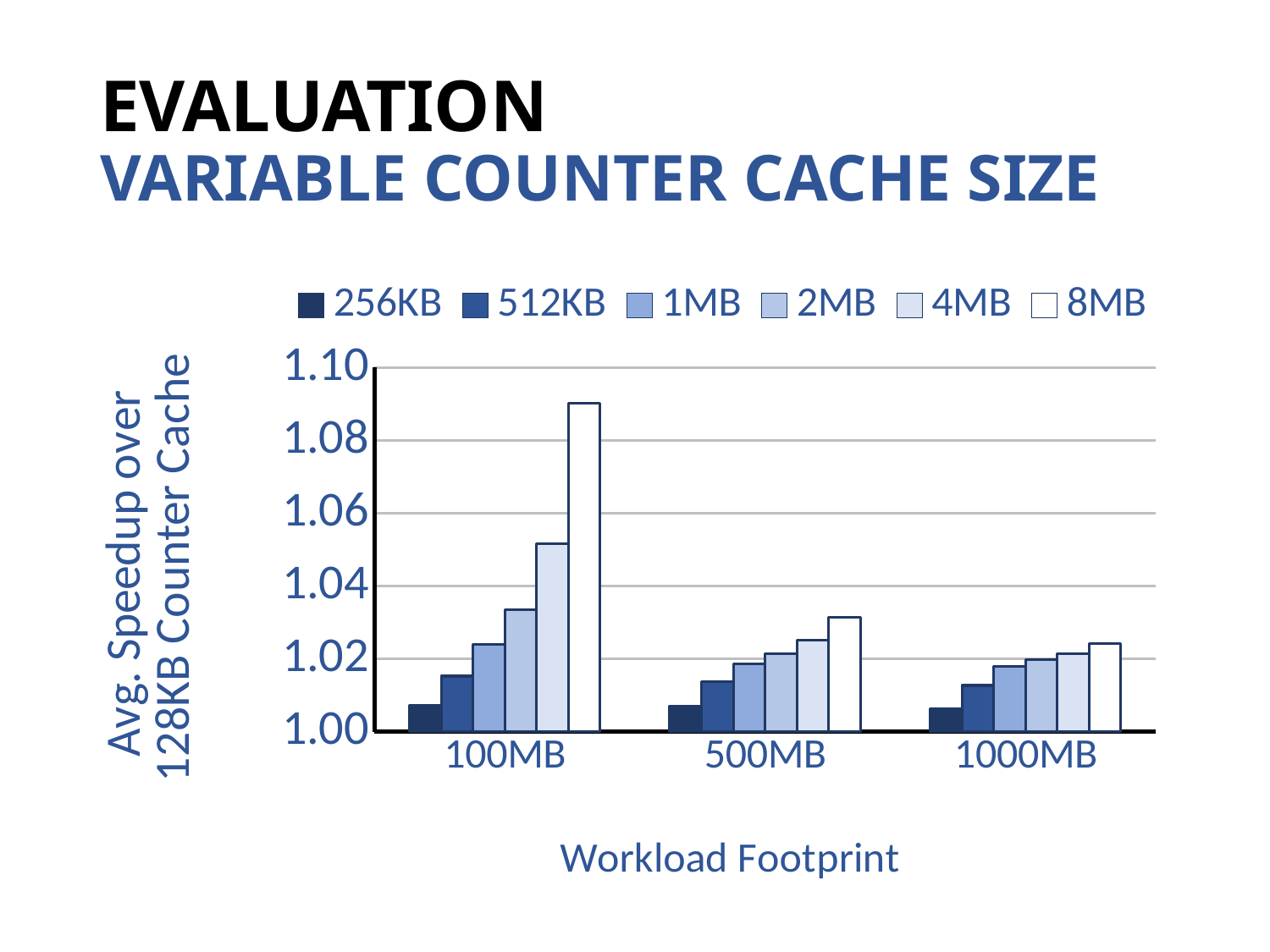
Which counter cache size has the lowest speedup for the 100MB workload footprint? 256KB What kind of chart is shown on the slide? bar chart Is the value for 8MB at the 500MB workload footprint greater or less than 1.04? less Is the value for 8MB at the 100MB workload footprint greater or less than 1.08? greater Within the 100MB workload footprint group, do the bars rise or fall as the counter cache size increases from 256KB to 8MB? rise What is the title of the x axis? Workload Footprint Which is larger: the 8MB value at 100MB or the 8MB value at 500MB? 8MB at 100MB How many series does the legend list? 6 Is the value for 8MB at the 1000MB workload footprint greater or less than 1.04? less How many workload footprint categories are shown on the x axis? 3 For which workload footprint is the 8MB bar the tallest? 100MB